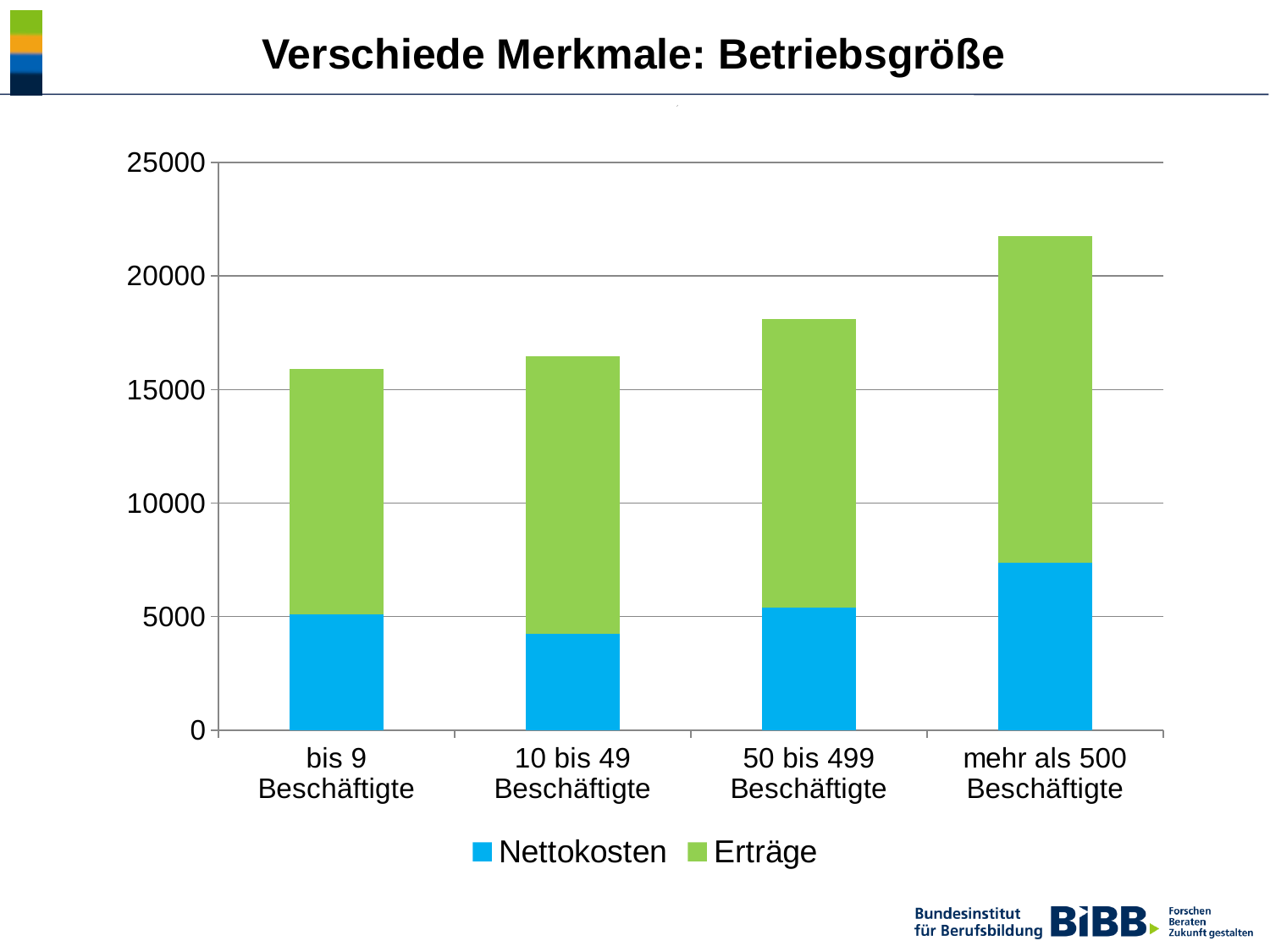
Is the Nettokosten value for mehr als 500 Beschäftigte greater or less than 5000? greater How many categories (company size groups) are shown on the x axis? 4 Is the Nettokosten value for 10 bis 49 Beschäftigte greater or less than 5000? less Which category has the lowest Nettokosten value? 10 bis 49 Beschäftigte Which category has the highest total stacked bar? mehr als 500 Beschäftigte What kind of chart is shown on the slide? stacked bar chart What is the title of the slide? Verschiede Merkmale: Betriebsgröße Which series is shown in blue? Nettokosten Do the total stacked bar heights rise or fall from left to right along the x axis? rise Is the total stacked bar for mehr als 500 Beschäftigte greater or less than 20000? greater Which category has the highest Nettokosten value? mehr als 500 Beschäftigte How many series does the legend list? 2